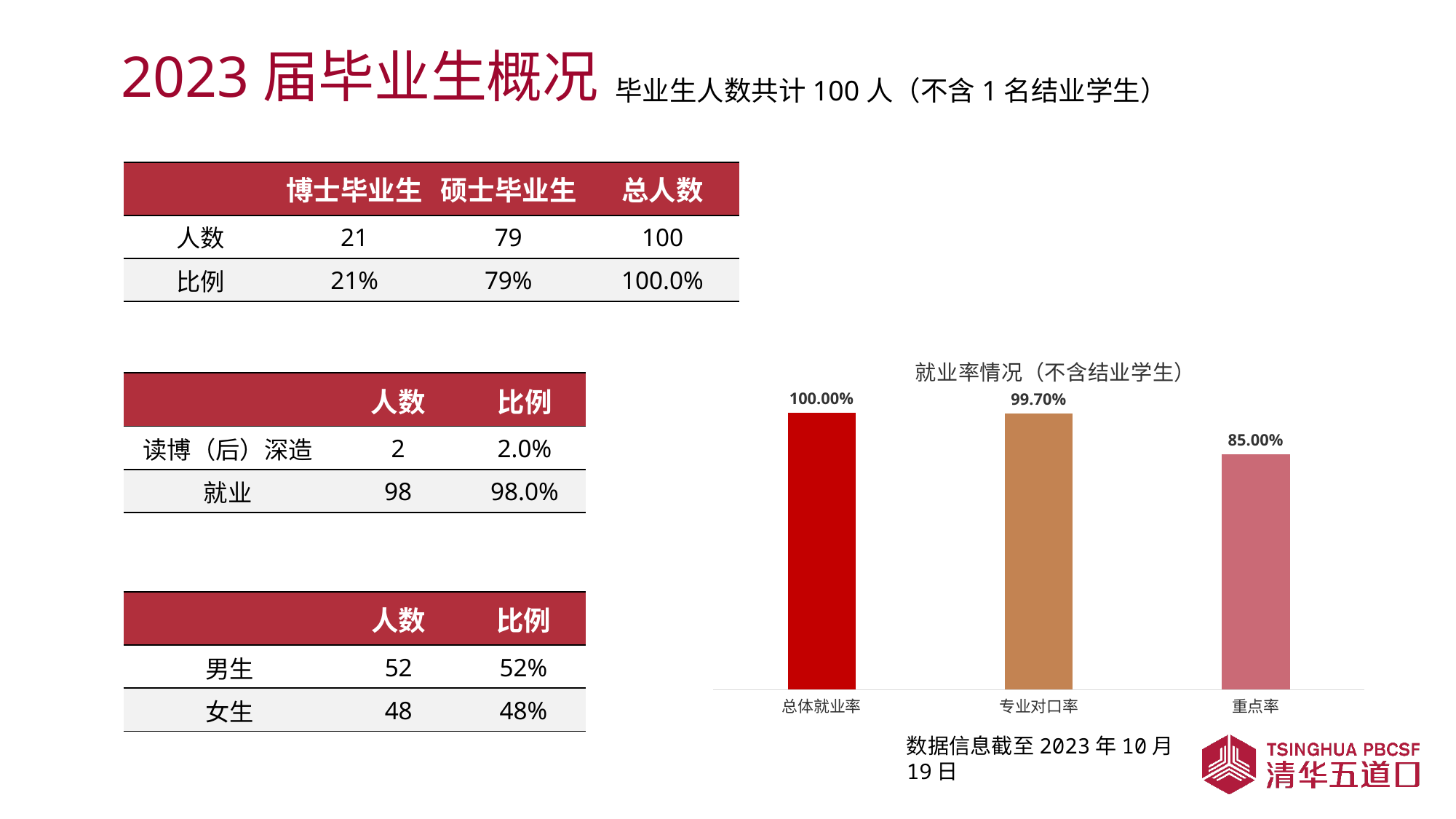
How many categories are shown in the chart? 3 What kind of chart is shown on the slide? bar chart What is the difference between the values for 总体就业率 and 专业对口率? 0.30% Which category has the lowest value in the chart? 重点率 What is the title of the chart? 就业率情况（不含结业学生） Which is larger, the value for 专业对口率 or the value for 重点率? 专业对口率 Which category has the highest value in the chart? 总体就业率 What is the difference between the values for 总体就业率 and 重点率? 15.00% What is the value for 重点率 in the chart? 85.00% What is the difference between the values for 专业对口率 and 重点率? 14.70% What is the value for 总体就业率 in the chart? 100.00% What is the value for 专业对口率 in the chart? 99.70%